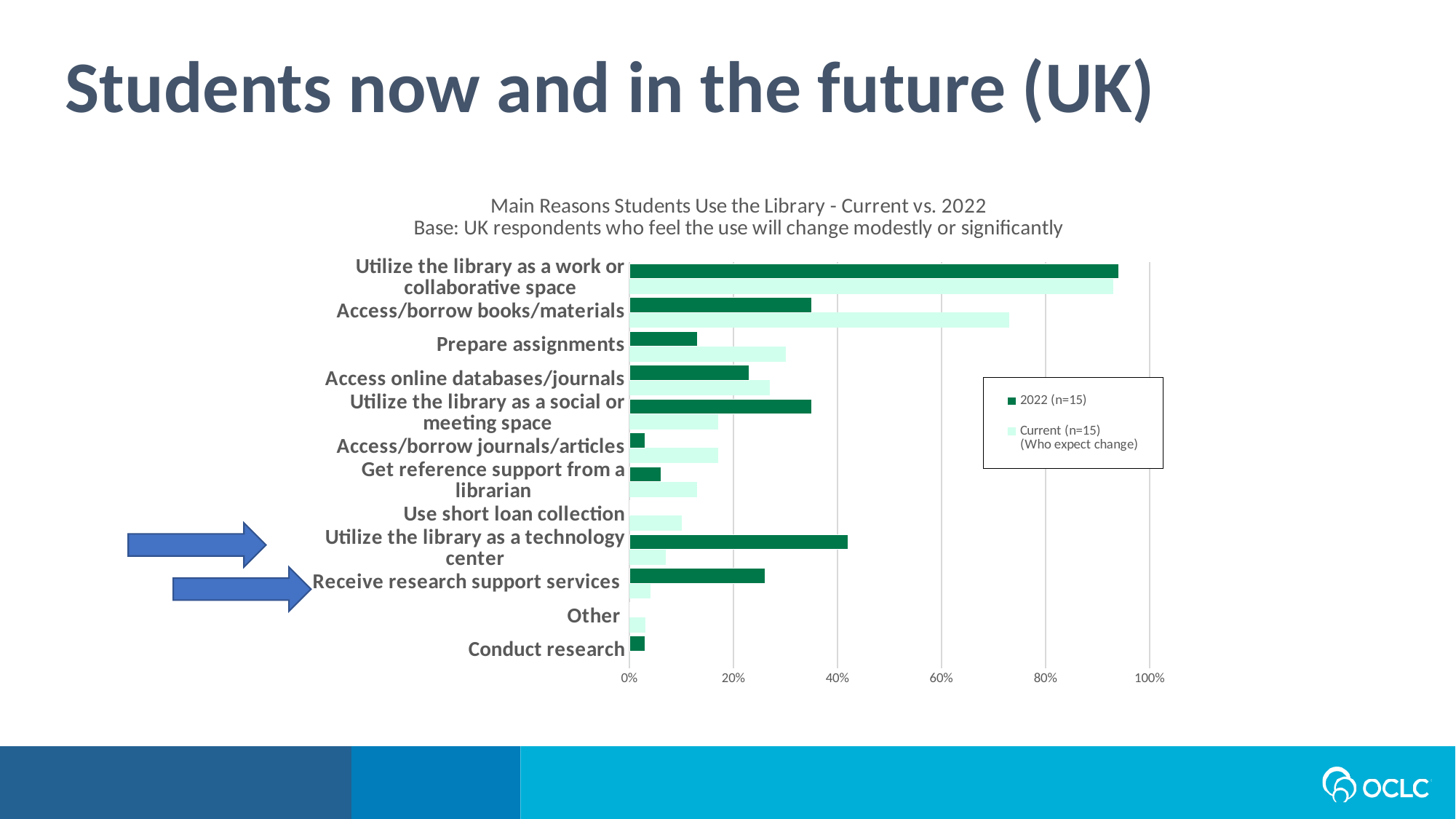
Which reason has the highest value for the Current (n=15) series? Utilize the library as a work or collaborative space Is the 2022 (n=15) value for Utilize the library as a technology center greater or less than 20%? greater Which reason has the highest value for the 2022 (n=15) series? Utilize the library as a work or collaborative space What is the title of the chart? Main Reasons Students Use the Library - Current vs. 2022 Base: UK respondents who feel the use will change modestly or significantly How many series does the legend list? 2 How many reasons (categories) are plotted on the chart? 12 For Access/borrow books/materials, which series has the larger value, 2022 (n=15) or Current (n=15)? Current (n=15) Is the Current (n=15) value for Access/borrow books/materials greater or less than 60%? greater For Receive research support services, which series has the larger value, 2022 (n=15) or Current (n=15)? 2022 (n=15) Is the 2022 (n=15) value for Utilize the library as a social or meeting space greater or less than 40%? less What kind of chart is shown on the slide? bar chart For Utilize the library as a technology center, which series has the larger value, 2022 (n=15) or Current (n=15)? 2022 (n=15)